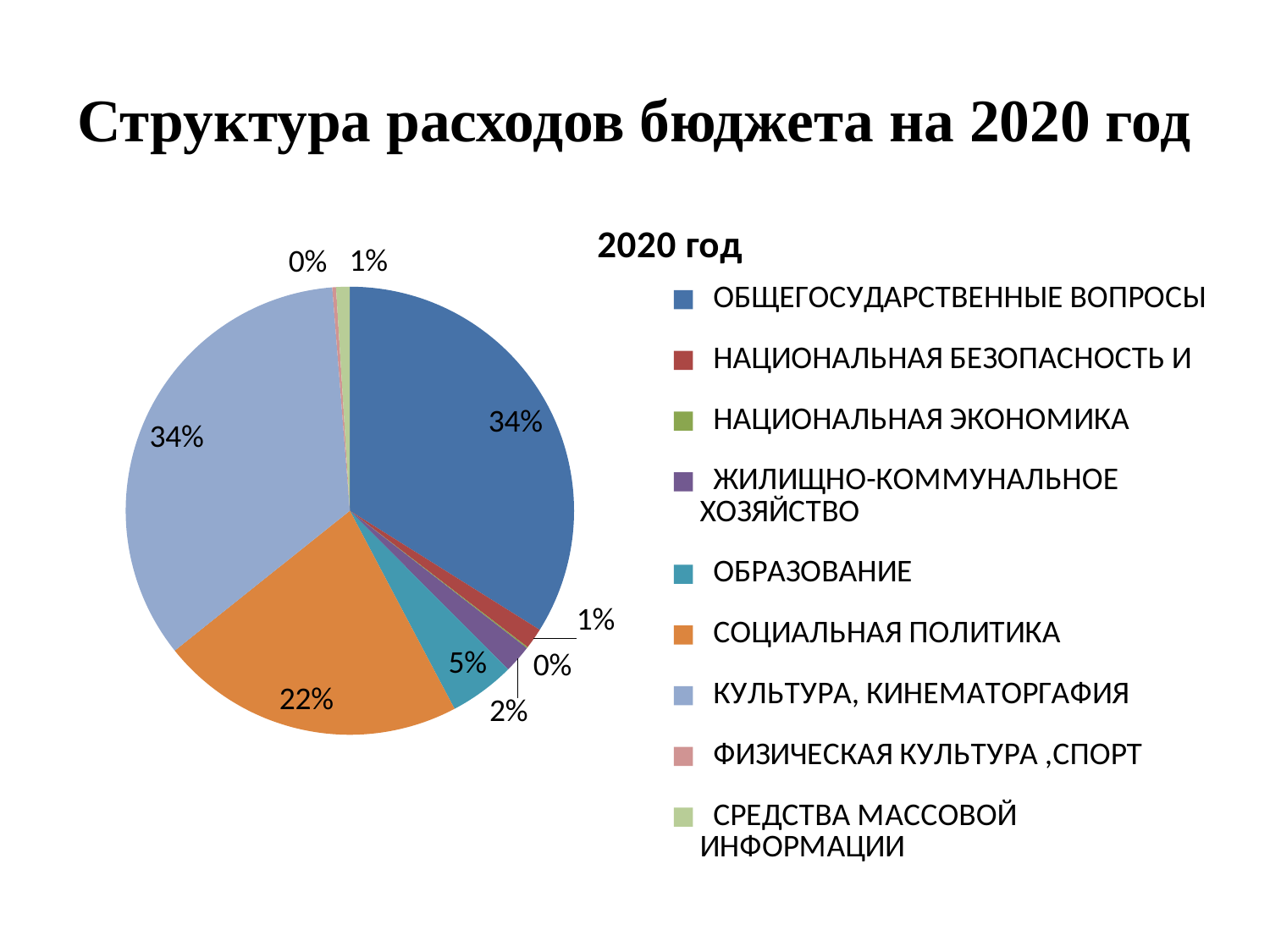
What share of the pie is ОБРАЗОВАНИЕ? 5% What is the title of the chart? 2020 год What is the difference in percentage points between the share for ОБЩЕГОСУДАРСТВЕННЫЕ ВОПРОСЫ and the share for СОЦИАЛЬНАЯ ПОЛИТИКА? 12 Which is larger, the share for СОЦИАЛЬНАЯ ПОЛИТИКА or the share for ОБРАЗОВАНИЕ? СОЦИАЛЬНАЯ ПОЛИТИКА What share of the pie is ЖИЛИЩНО-КОММУНАЛЬНОЕ ХОЗЯЙСТВО? 2% What type of chart is shown on the slide? pie chart What share of the pie is НАЦИОНАЛЬНАЯ БЕЗОПАСНОСТЬ И? 1% What share of the pie is ОБЩЕГОСУДАРСТВЕННЫЕ ВОПРОСЫ? 34% What colour is the slice for СОЦИАЛЬНАЯ ПОЛИТИКА? orange How many categories does the legend list? 9 What share of the pie is СОЦИАЛЬНАЯ ПОЛИТИКА? 22% What share of the pie is КУЛЬТУРА, КИНЕМАТОРГАФИЯ? 34%